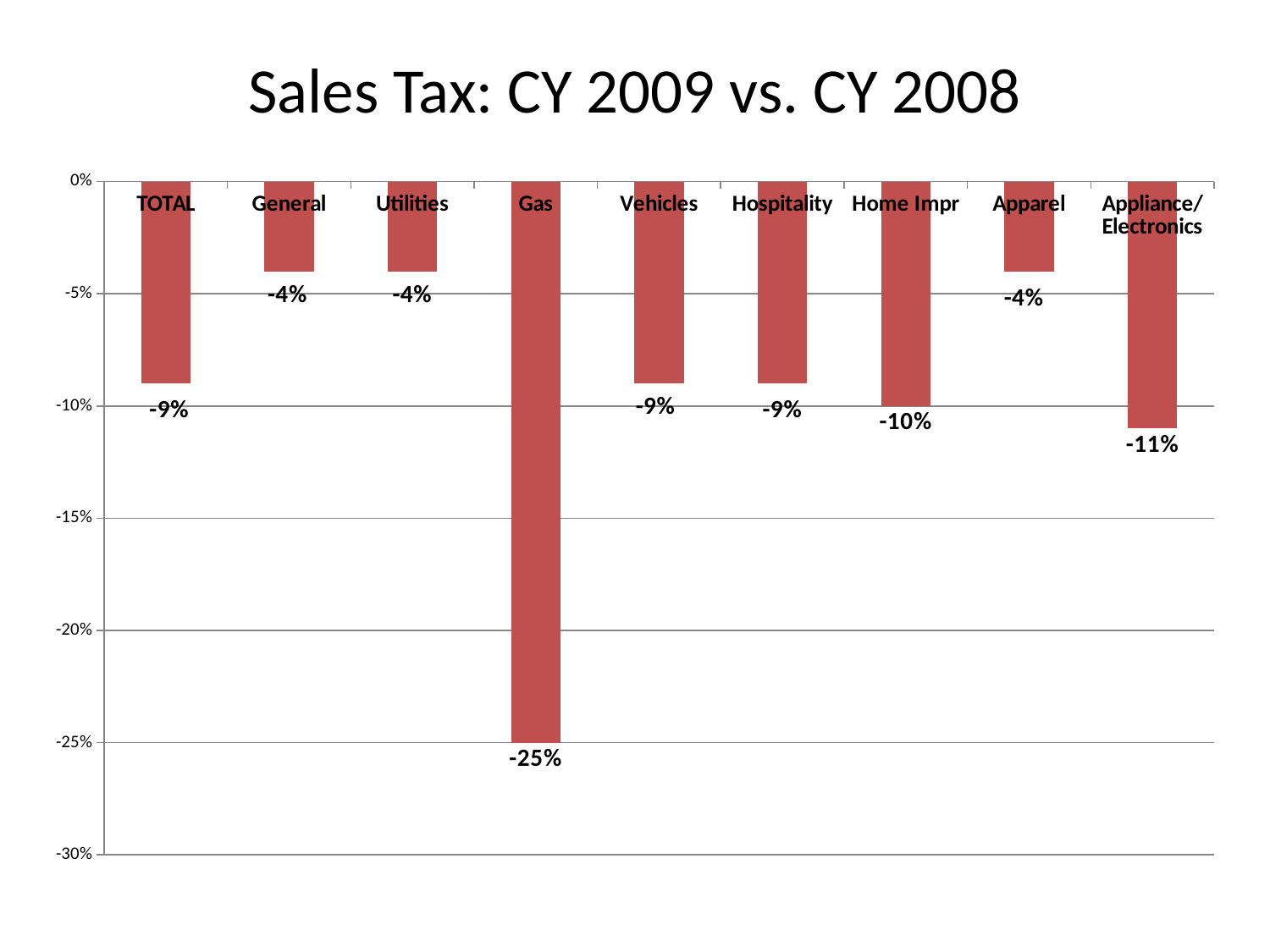
Is the value for Gas greater or less than -20%? less Which has a larger decline, Vehicles or Apparel? Vehicles What is the value for Home Impr? -10% What is the value for Gas? -25% What is the title of the chart? Sales Tax: CY 2009 vs. CY 2008 What is the value for TOTAL? -9% Which category has the lowest (most negative) value? Gas What is the difference between the values for Gas and Appliance/Electronics? 14% How many categories are shown on the chart? 9 What is the difference between the values for Home Impr and General? 6% What is the value for Appliance/Electronics? -11% What kind of chart is shown on the slide? bar chart